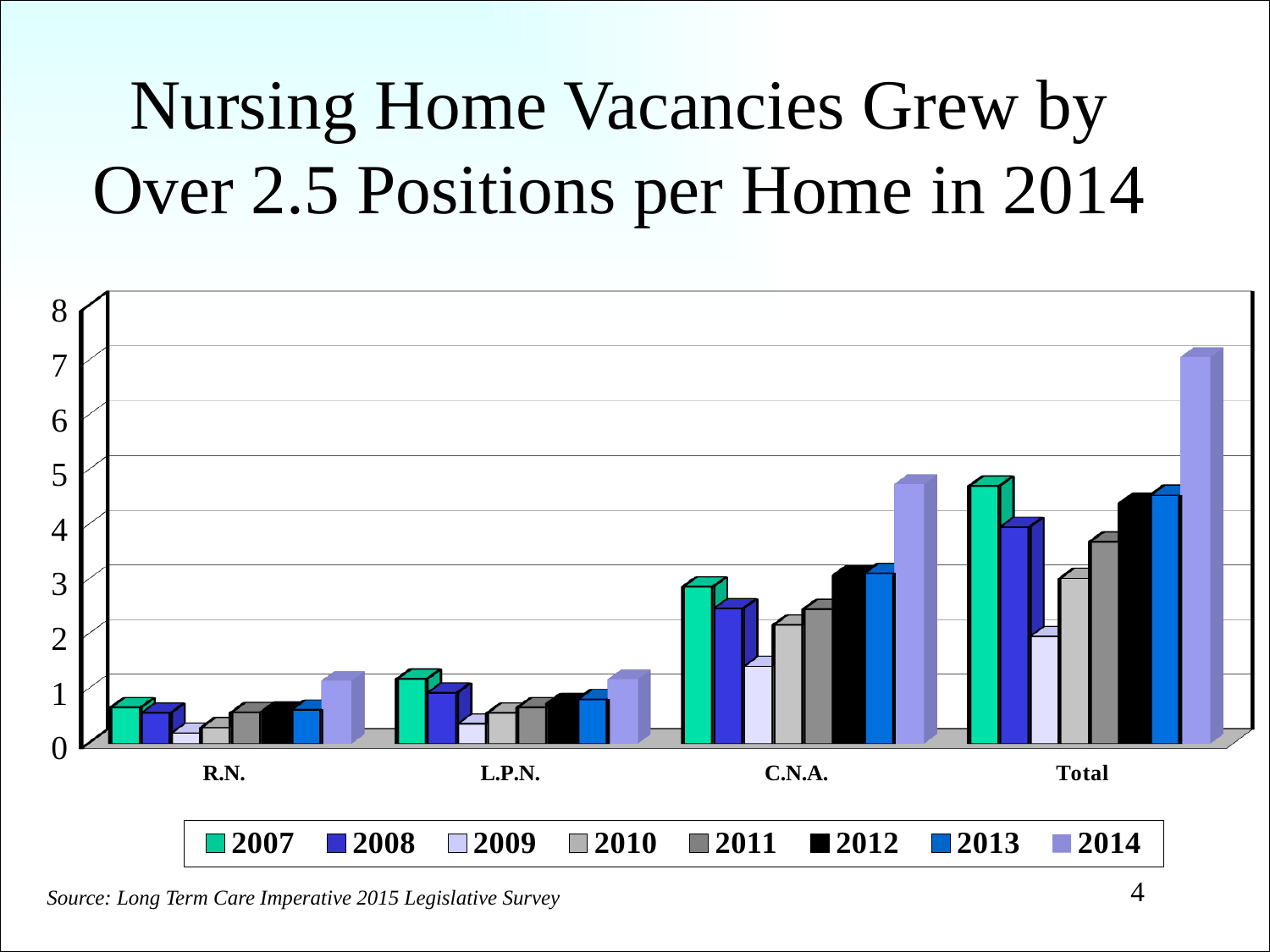
How many categories are shown on the x axis? 4 How many series does the legend list? 8 Is the value for Total in 2011 greater or less than 4? less Which is larger, the value for C.N.A. in 2012 or the value for C.N.A. in 2009? 2012 Which year has the lowest value for Total? 2009 Is the value for Total in 2014 greater or less than 6? greater Which year has the highest value for Total? 2014 Which category has the highest value for 2014? Total What kind of chart is shown on the slide? bar chart Is the value for C.N.A. in 2009 greater or less than 2? less Which year has the highest value for C.N.A.? 2014 What is the title of the slide? Nursing Home Vacancies Grew by Over 2.5 Positions per Home in 2014